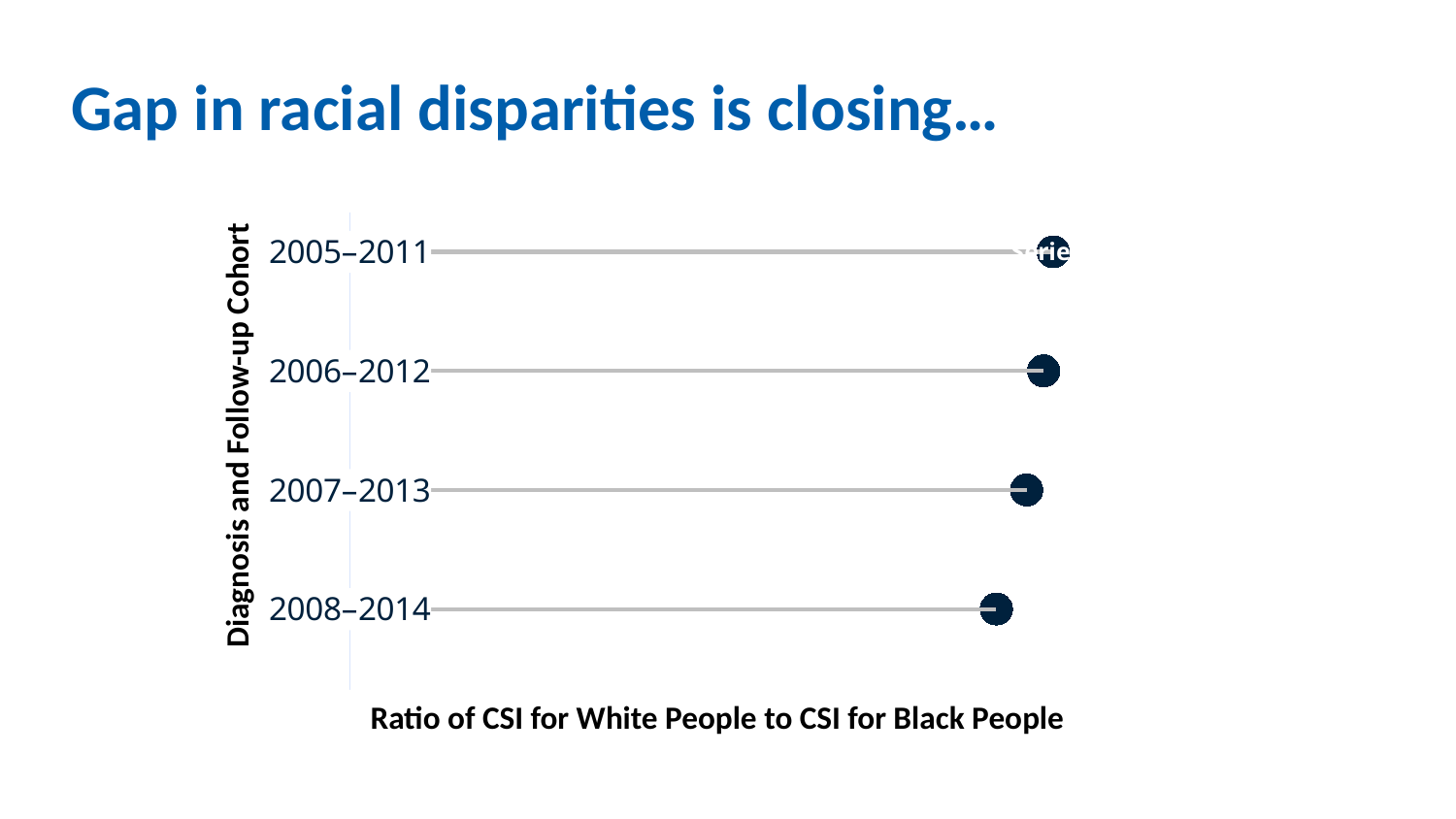
Does the ratio increase or decrease from the 2005–2011 cohort to the 2008–2014 cohort? decrease Which cohort has a higher ratio, 2007–2013 or 2008–2014? 2007–2013 What is the title of the slide containing the chart? Gap in racial disparities is closing… Which cohort has the lowest ratio of CSI for White People to CSI for Black People? 2008–2014 Which cohort has a higher ratio, 2005–2011 or 2008–2014? 2005–2011 Which cohort has a higher ratio, 2006–2012 or 2008–2014? 2006–2012 What is the label of the horizontal axis of the chart? Ratio of CSI for White People to CSI for Black People How many cohorts are plotted on the chart? 4